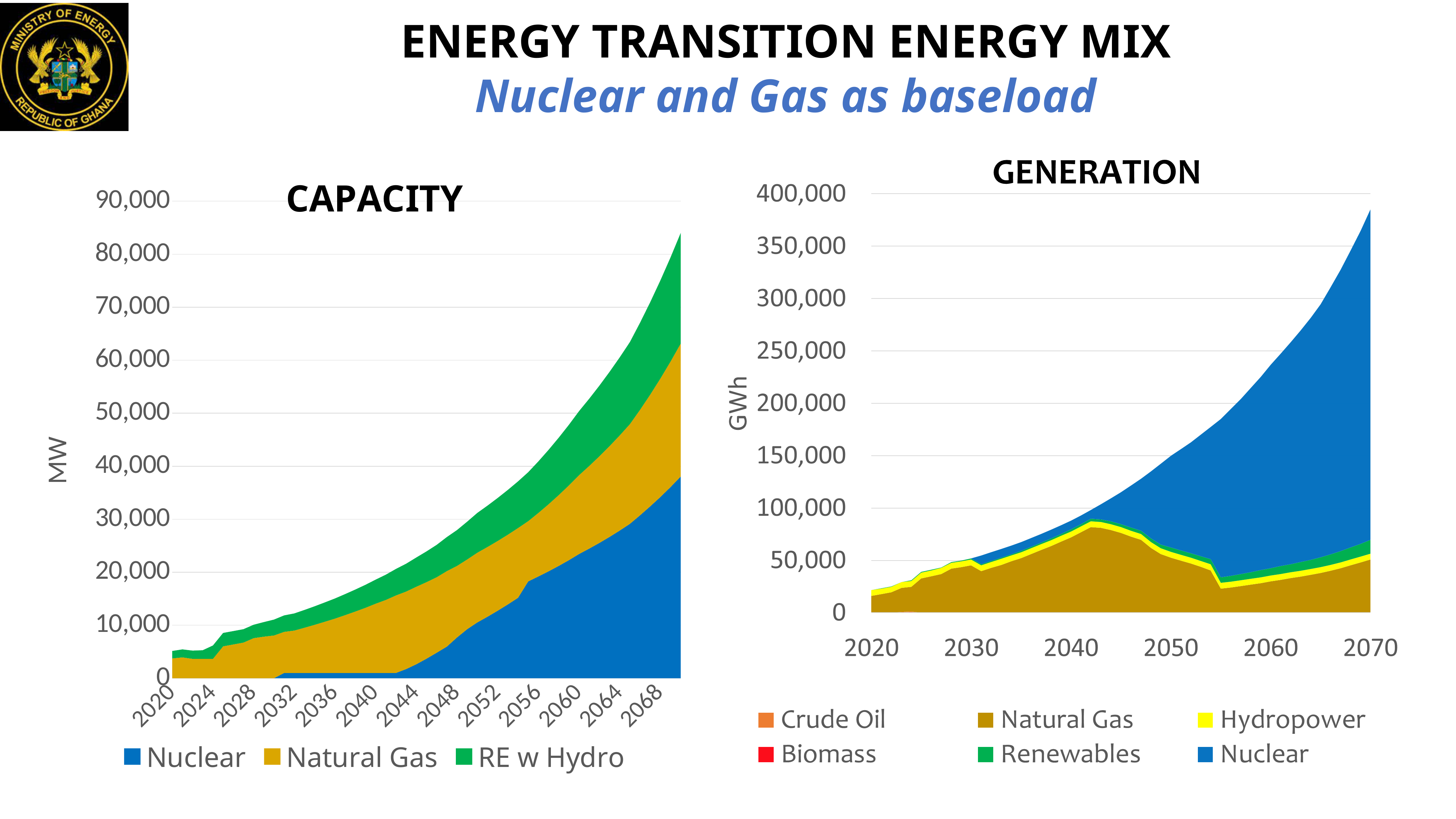
What unit is shown on the y axis of the GENERATION chart? GWh How many series does the legend of the CAPACITY chart list? 3 What unit is shown on the y axis of the CAPACITY chart? MW In the GENERATION chart, is the total generation in 2020 greater or less than 50,000? less In the CAPACITY chart, is the total capacity in 2068 greater or less than 70,000? greater How many series does the legend of the GENERATION chart list? 6 In the GENERATION chart, does the total generation rise or fall from 2020 to 2070? rise In the GENERATION chart, is the total generation in 2070 greater or less than 350,000? greater What kind of chart is the CAPACITY chart? stacked area chart What kind of chart is the GENERATION chart? stacked area chart In the CAPACITY chart, does the total capacity rise or fall from 2020 to 2068? rise